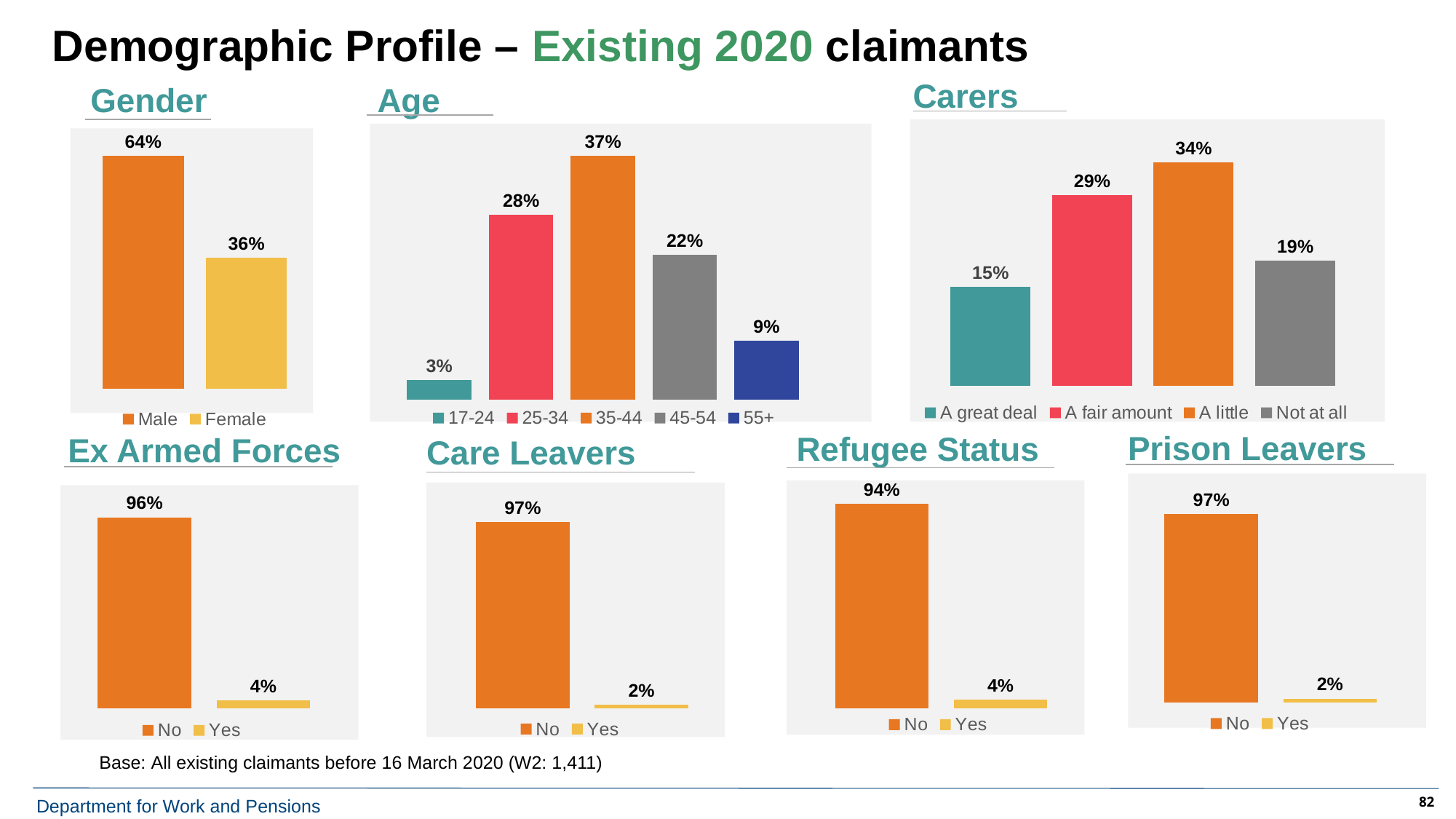
In the Age chart, what is the difference between the 35-44 and 25-34 values? 9% In the Ex Armed Forces chart, what is the value for Yes? 4% In the Refugee Status chart, what is the value for No? 94% In the Carers chart, what is the value for 'A fair amount'? 29% What type of chart is the Care Leavers chart? Bar chart In the Gender chart, what percentage of claimants are Male? 64% How many categories does the Age chart's legend list? 5 In the Age chart, which age group has the lowest value? 17-24 In the Age chart, which age group has the highest value? 35-44 In the Carers chart, which category has the highest value? A little In the Prison Leavers chart, what is the difference between the No and Yes values? 95% In the Carers chart, which is larger: 'A great deal' or 'Not at all'? Not at all